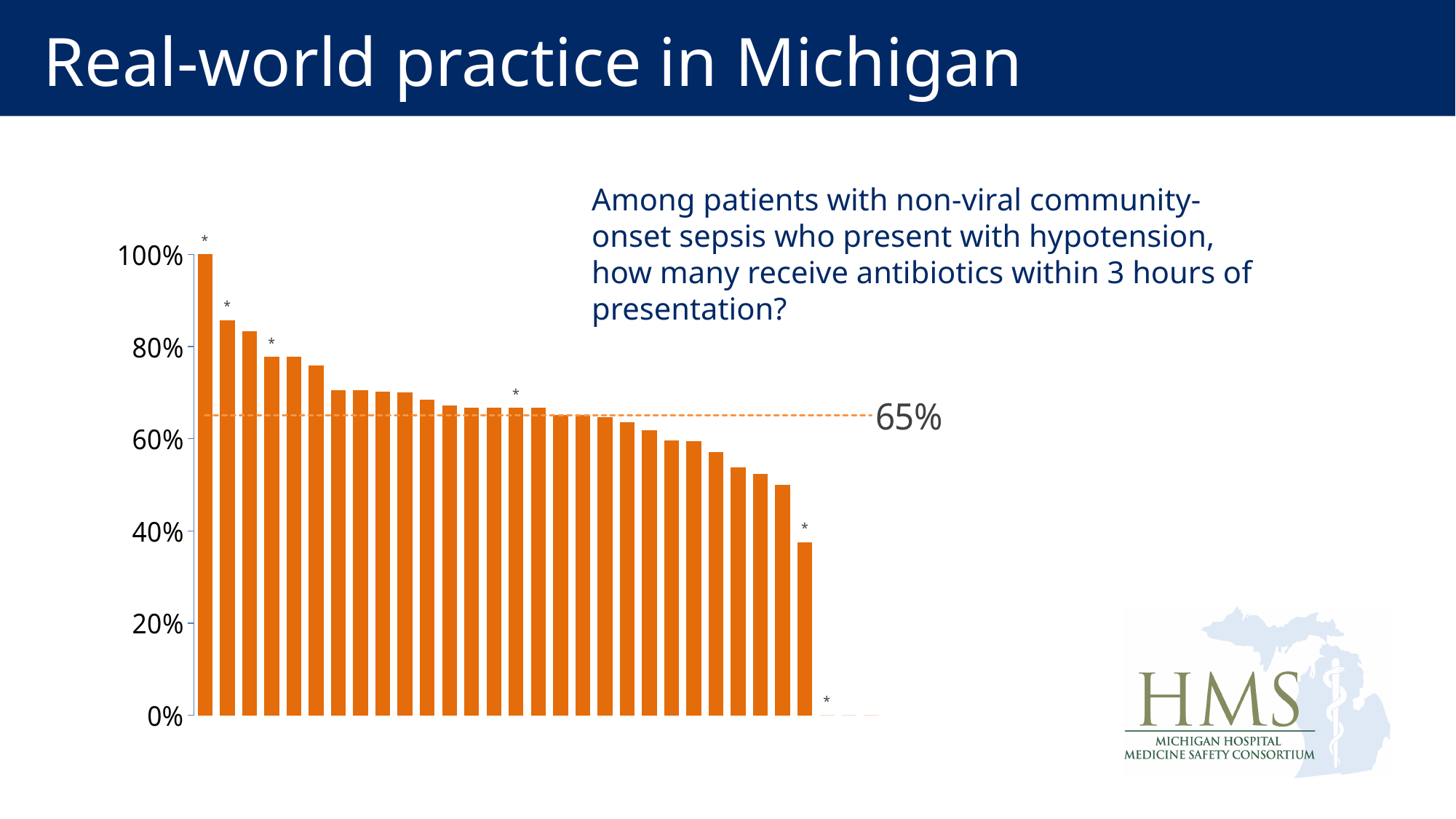
Is the dashed reference line value greater or less than 60%? greater What kind of chart is shown on the slide? bar chart What colour are the bars in the chart? orange What is the highest tick value shown on the y-axis? 100% Is the value of the leftmost (tallest) bar greater or less than 80%? greater Do the bar values rise or fall from left to right across the chart? fall How many bars exceed 80%? 3 Which bar is taller, the leftmost bar or the rightmost orange bar? the leftmost bar Is the value of the shortest orange bar (the rightmost tall bar, marked with an asterisk) greater or less than 40%? less What value is labelled on the dashed horizontal reference line in the chart? 65%